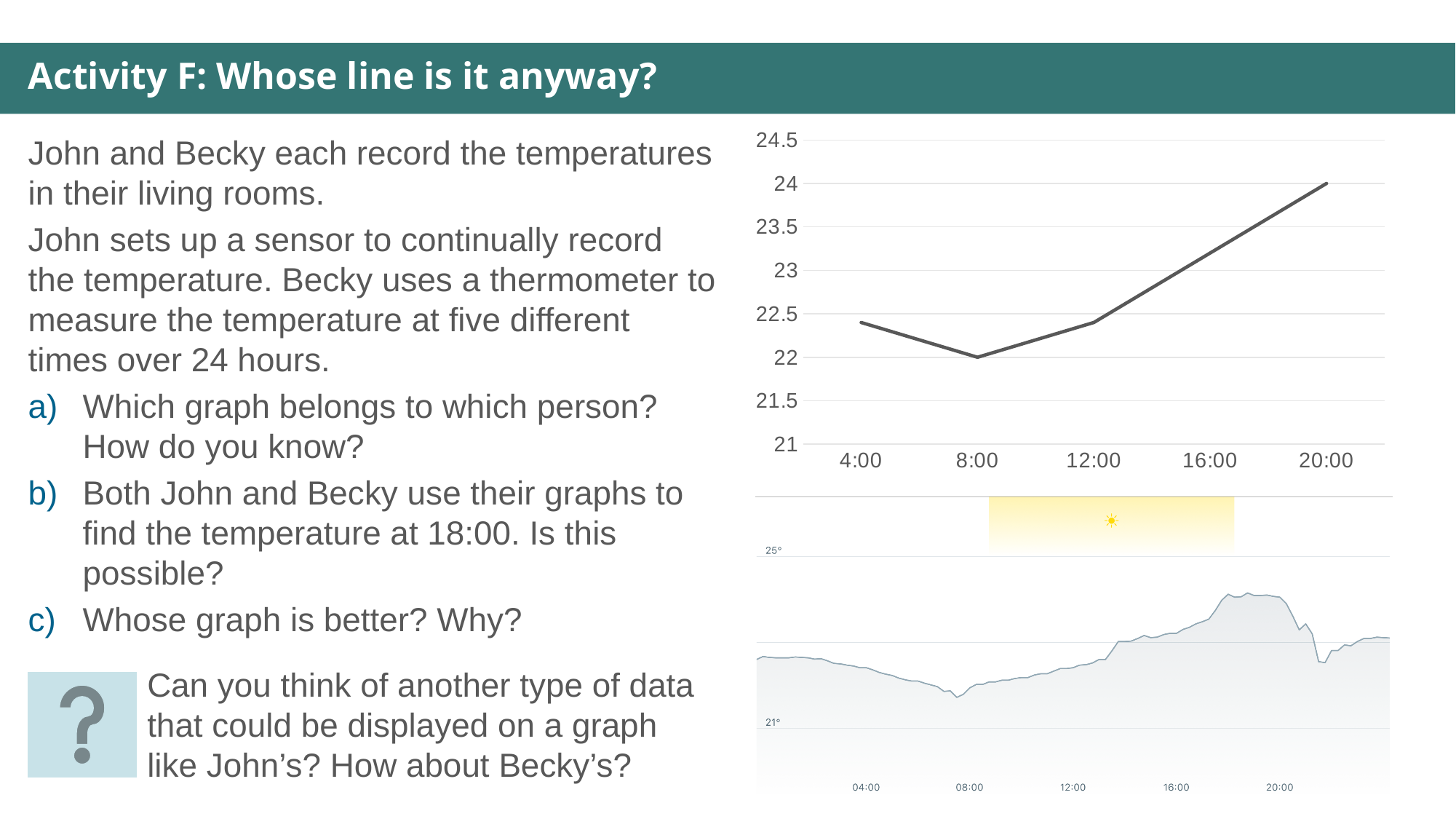
On the top chart, do the values rise or fall between 8:00 and 20:00? rise On the top chart, at which time is the temperature lowest? 8:00 On the top chart, what is the temperature value at 8:00? 22 On the top chart, at which time is the temperature highest? 20:00 On the top chart, is the value at 4:00 greater or less than 23? less On the bottom chart, is the value at 08:00 greater or less than 21°? greater What kind of chart is the top chart on the slide? line chart How many data points are plotted on the top line chart? 5 On the top chart, is the value at 16:00 greater or less than 22.5? greater On the top chart, what is the difference between the values at 20:00 and 8:00? 2 On the top chart, what is the temperature value at 20:00? 24 On the top chart, which time has the larger value, 4:00 or 20:00? 20:00